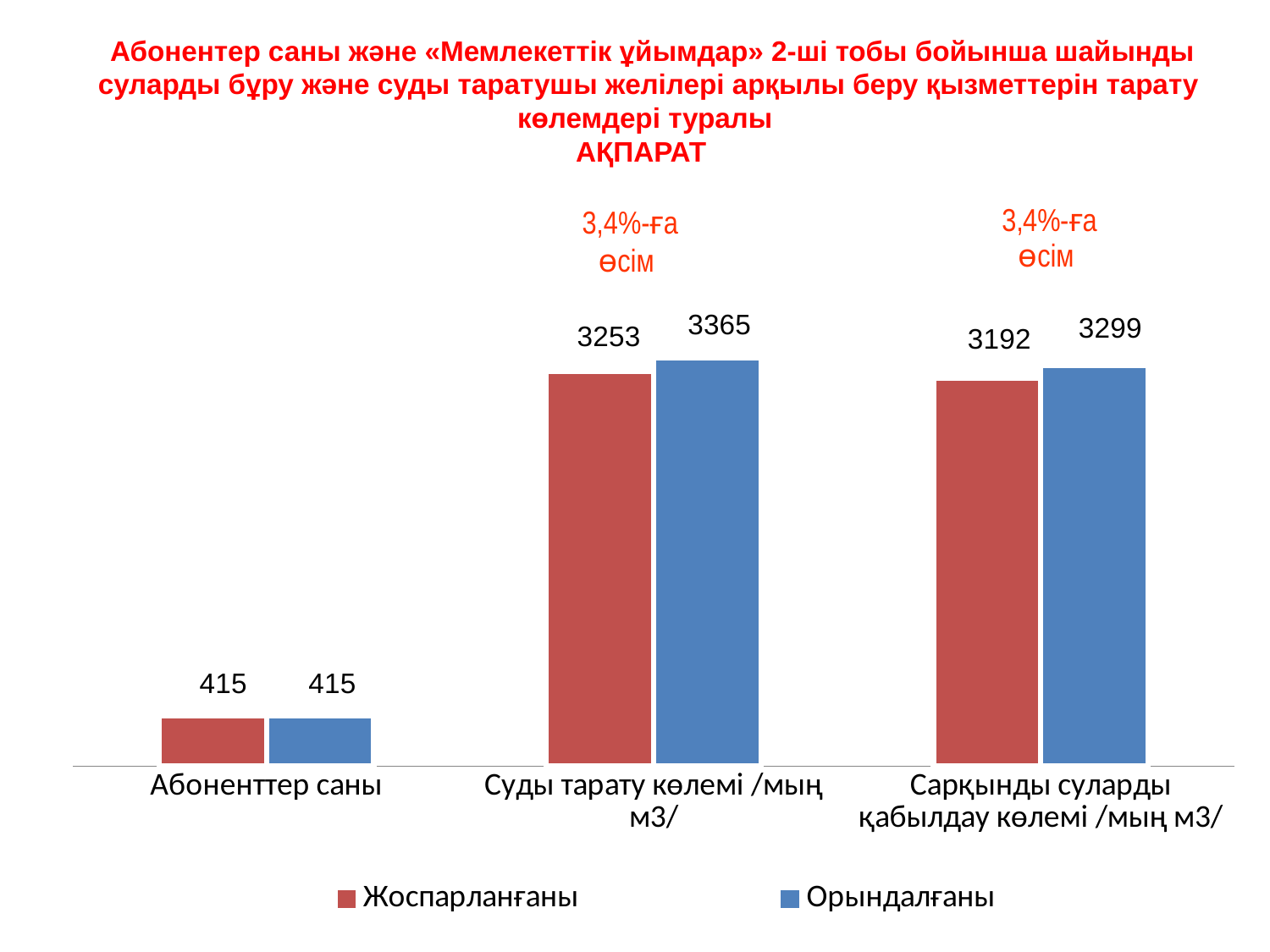
What is the Жоспарланғаны value for Абоненттер саны? 415 What is the Жоспарланғаны value for Сарқынды суларды қабылдау көлемі /мың м3/? 3192 What is the Орындалғаны value for Сарқынды суларды қабылдау көлемі /мың м3/? 3299 Which category has the lowest Жоспарланғаны value? Абоненттер саны Which is larger for Сарқынды суларды қабылдау көлемі /мың м3/: Жоспарланғаны or Орындалғаны? Орындалғаны How many categories are shown on the x axis? 3 What is the Орындалғаны value for Суды тарату көлемі /мың м3/? 3365 What is the difference between the Орындалғаны and Жоспарланғаны values for Суды тарату көлемі /мың м3/? 112 How many series does the legend list? 2 Which category has the highest Орындалғаны value? Суды тарату көлемі /мың м3/ What is the difference between the Орындалғаны and Жоспарланғаны values for Сарқынды суларды қабылдау көлемі /мың м3/? 107 What kind of chart is shown on the slide? Bar chart